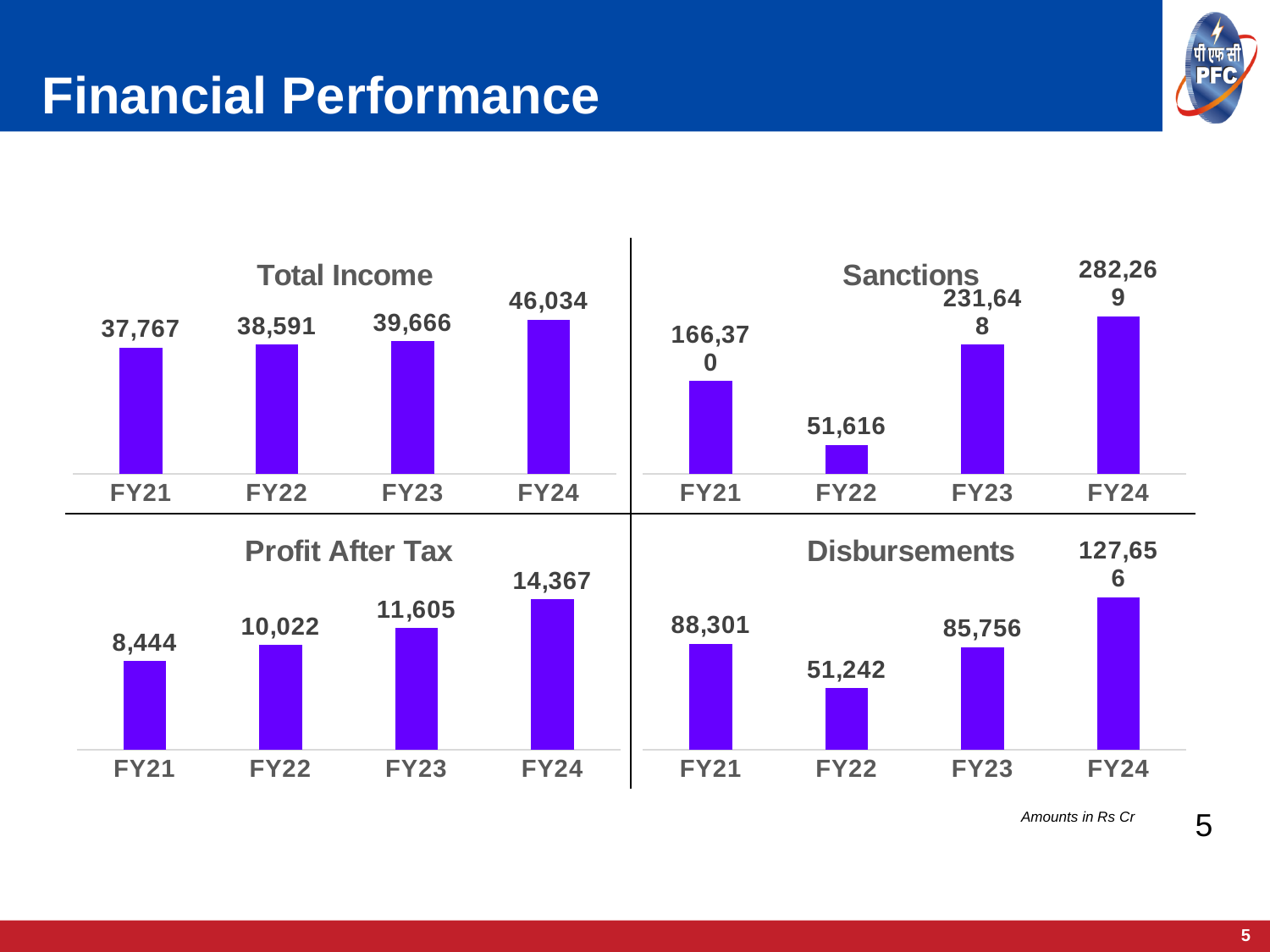
In the Profit After Tax chart, what is the value for FY21? 8,444 In the Total Income chart, what is the value for FY24? 46,034 In the Sanctions chart, what is the value for FY22? 51,616 In the Profit After Tax chart, what is the difference between the FY24 and FY21 values? 5,923 What type of chart is the Total Income chart? Bar chart In the Total Income chart, what is the difference between the FY24 and FY23 values? 6,368 How many years are shown in the Profit After Tax chart? 4 In the Sanctions chart, which year has the highest value? FY24 In the Disbursements chart, what is the value for FY23? 85,756 In the Disbursements chart, which is larger, the value for FY21 or the value for FY23? FY21 In the Disbursements chart, which year has the lowest value? FY22 In the Profit After Tax chart, do the values rise or fall from FY21 to FY24? Rise